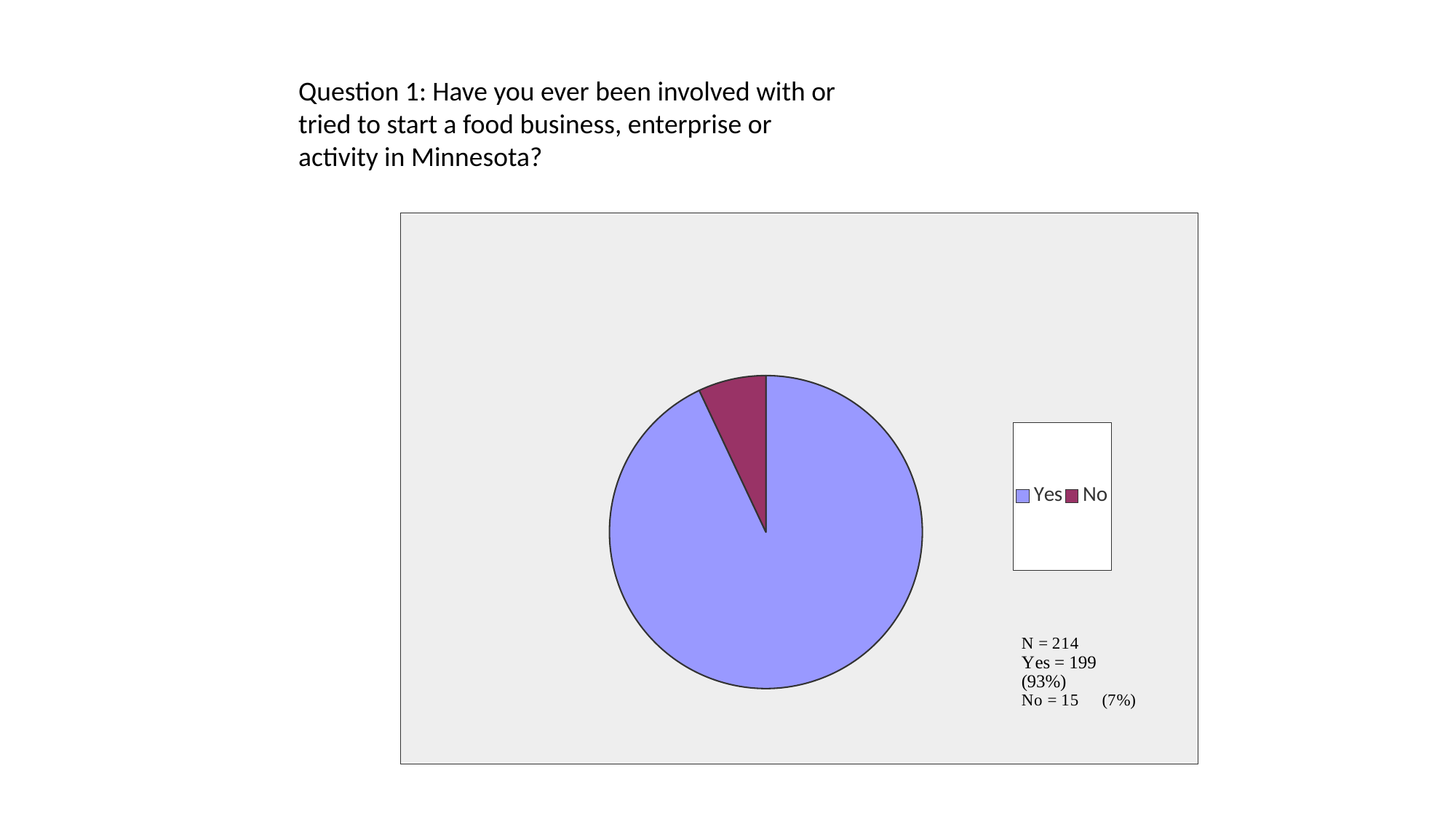
What is the difference between the number of Yes and No responses? 184 How many entries does the legend list? 2 How many respondents answered Yes? 199 What share of the pie is the No slice? 7% Which colour represents the No slice in the legend? dark red/maroon What kind of chart is shown on the slide? pie chart How many slices does the pie chart have? 2 What share of the pie is the Yes slice? 93% How many respondents answered No? 15 Which response has the smallest slice? No What is the total number of respondents (N)? 214 Which response has the largest slice? Yes